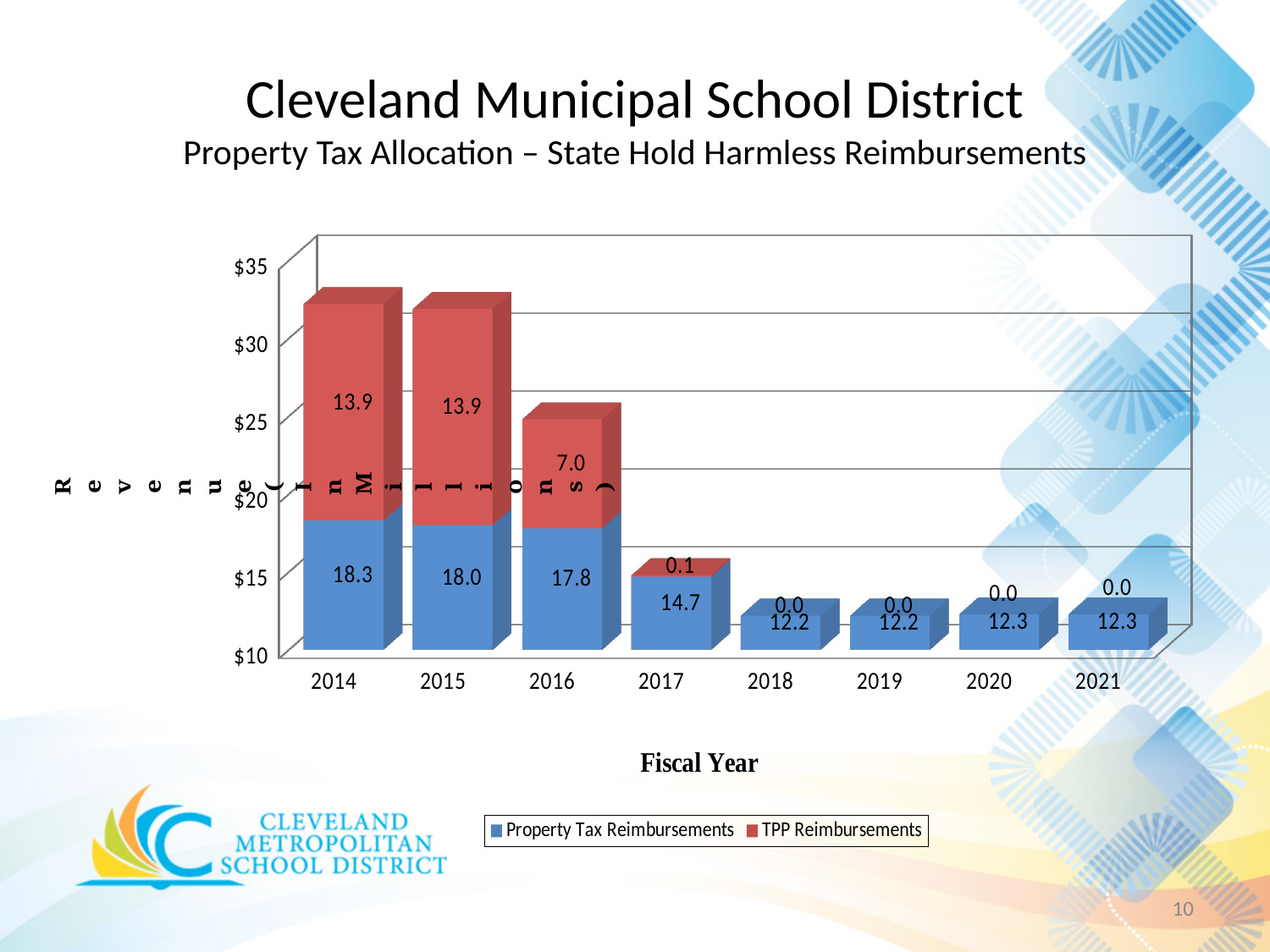
What is the value of Property Tax Reimbursements for fiscal year 2017? 14.7 What is the total of the stacked bar for fiscal year 2014? 32.2 Do the Property Tax Reimbursements values generally rise or fall from 2014 to 2021? Fall What is the value of TPP Reimbursements for fiscal year 2016? 7.0 What is the total of the stacked bar for fiscal year 2016? 24.8 What is the difference between the TPP Reimbursements values for 2015 and 2016? 6.9 How many series does the legend list? 2 How many fiscal years are shown on the x axis? 8 Which fiscal year has the highest Property Tax Reimbursements value? 2014 What kind of chart is shown on the slide? Stacked bar chart Which is larger, the Property Tax Reimbursements value for 2016 or for 2017? 2016 What is the value of Property Tax Reimbursements for fiscal year 2014? 18.3